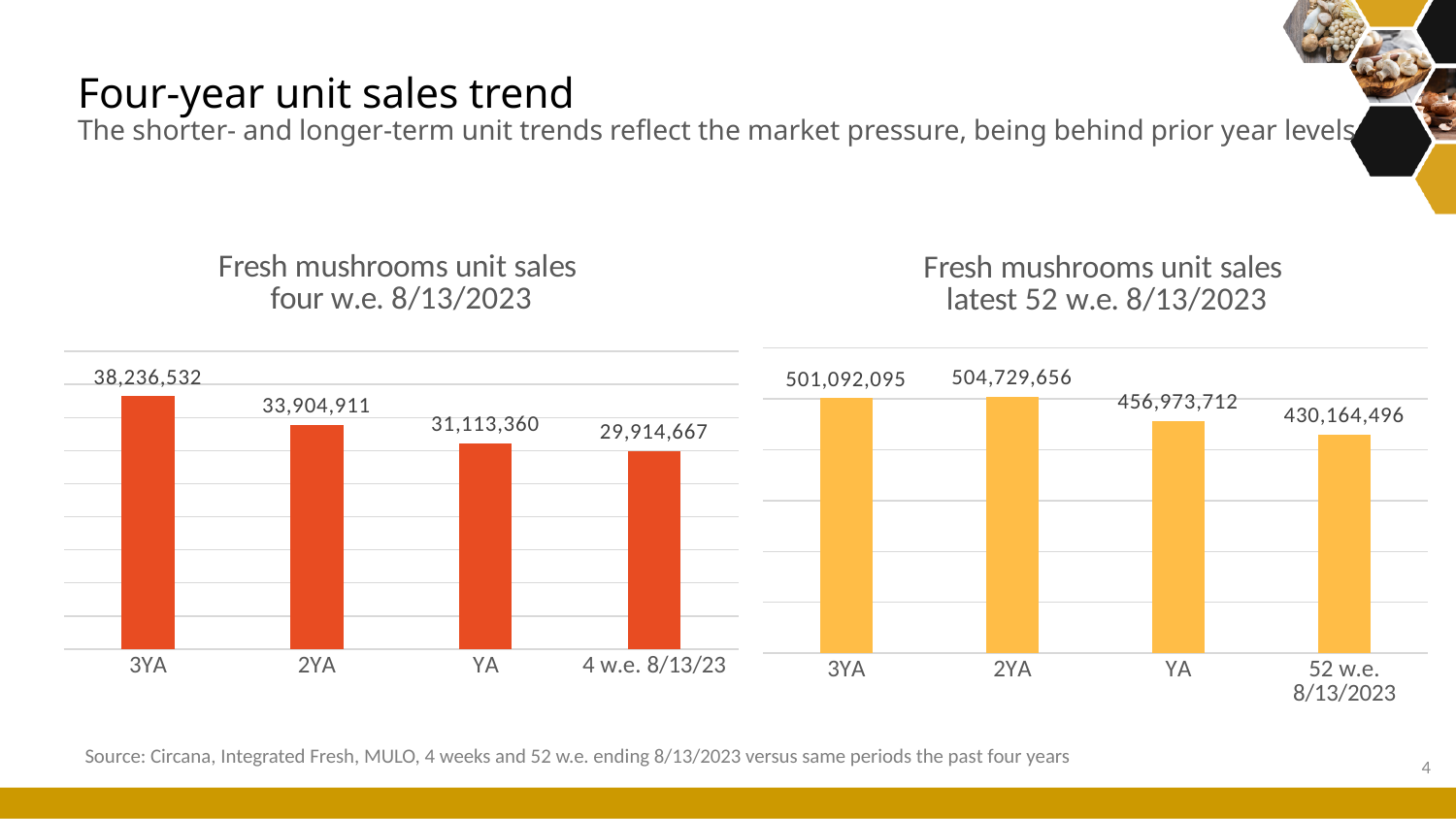
In the 'Fresh mushrooms unit sales latest 52 w.e. 8/13/2023' chart, which period has the highest value? 2YA In the 'Fresh mushrooms unit sales four w.e. 8/13/2023' chart, do the values rise or fall from 3YA to 4 w.e. 8/13/23? Fall What type of chart is the 'Fresh mushrooms unit sales latest 52 w.e. 8/13/2023' chart? Bar chart How many bars are in the 'Fresh mushrooms unit sales four w.e. 8/13/2023' chart? 4 In the 'Fresh mushrooms unit sales four w.e. 8/13/2023' chart, what is the value for 4 w.e. 8/13/23? 29,914,667 In the 'Fresh mushrooms unit sales latest 52 w.e. 8/13/2023' chart, what is the difference between the YA value and the 52 w.e. 8/13/2023 value? 26,809,216 In the 'Fresh mushrooms unit sales four w.e. 8/13/2023' chart, which period has the lowest value? 4 w.e. 8/13/23 In the 'Fresh mushrooms unit sales latest 52 w.e. 8/13/2023' chart, what is the value for YA? 456,973,712 In the 'Fresh mushrooms unit sales latest 52 w.e. 8/13/2023' chart, which is larger, the value for 3YA or the value for 2YA? 2YA In the 'Fresh mushrooms unit sales latest 52 w.e. 8/13/2023' chart, what is the value for 52 w.e. 8/13/2023? 430,164,496 In the 'Fresh mushrooms unit sales four w.e. 8/13/2023' chart, what is the difference between the 3YA value and the 4 w.e. 8/13/23 value? 8,321,865 In the 'Fresh mushrooms unit sales four w.e. 8/13/2023' chart, what is the value for 3YA? 38,236,532